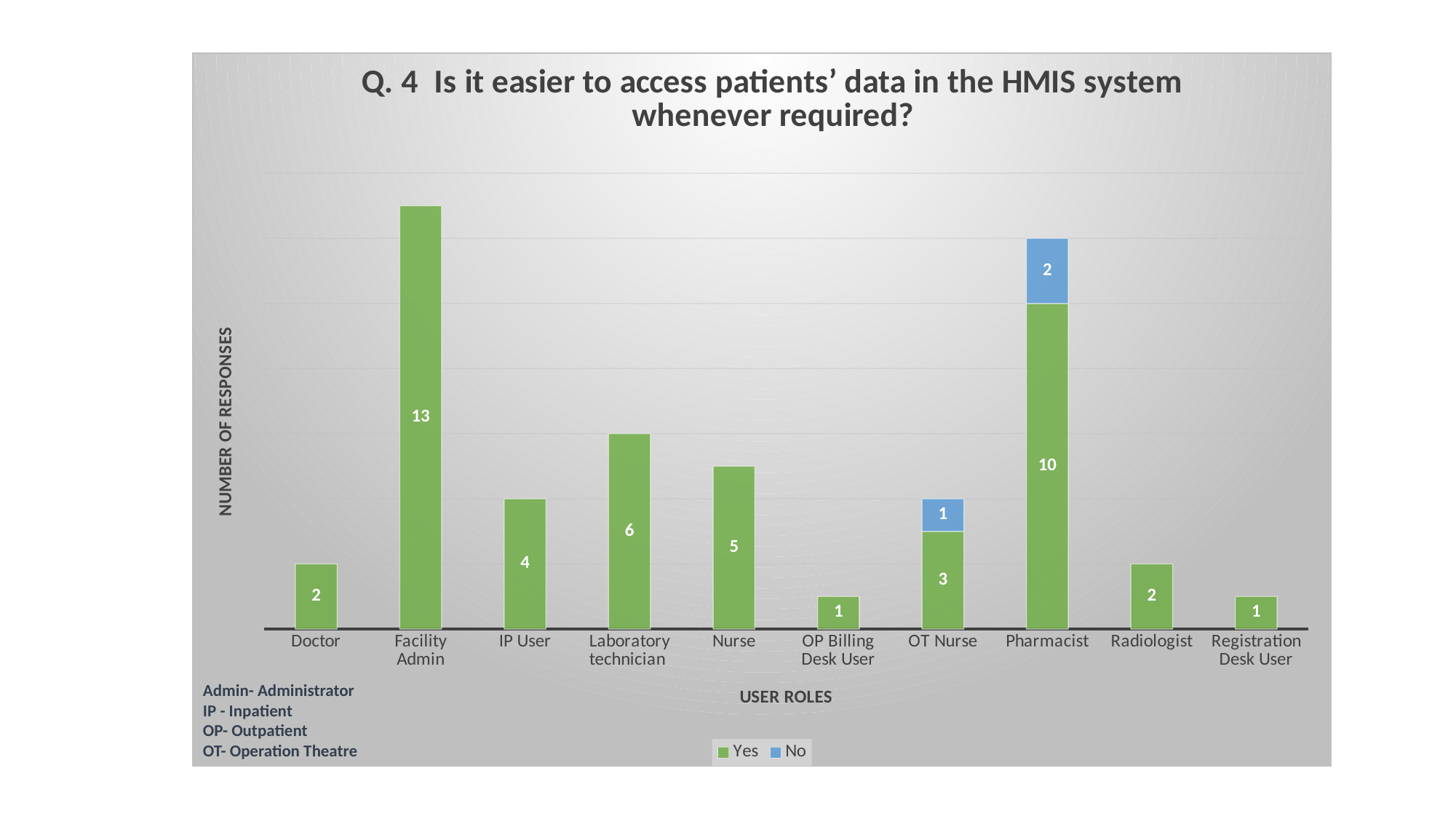
What is the difference between the 'Yes' responses for Facility Admin and Pharmacist? 3 What is the total number of responses for the OT Nurse bar? 4 How many 'Yes' responses did Facility Admin give? 13 How many 'No' responses did Pharmacist give? 2 What is the total number of responses for the Pharmacist bar? 12 How many user roles are shown on the x axis? 10 How many 'Yes' responses did OT Nurse give? 3 How many series does the legend list? 2 What kind of chart is shown on the slide? Stacked bar chart Which has more 'Yes' responses, Laboratory technician or Nurse? Laboratory technician What is the label of the vertical axis? NUMBER OF RESPONSES Which user role has the highest number of 'Yes' responses? Facility Admin